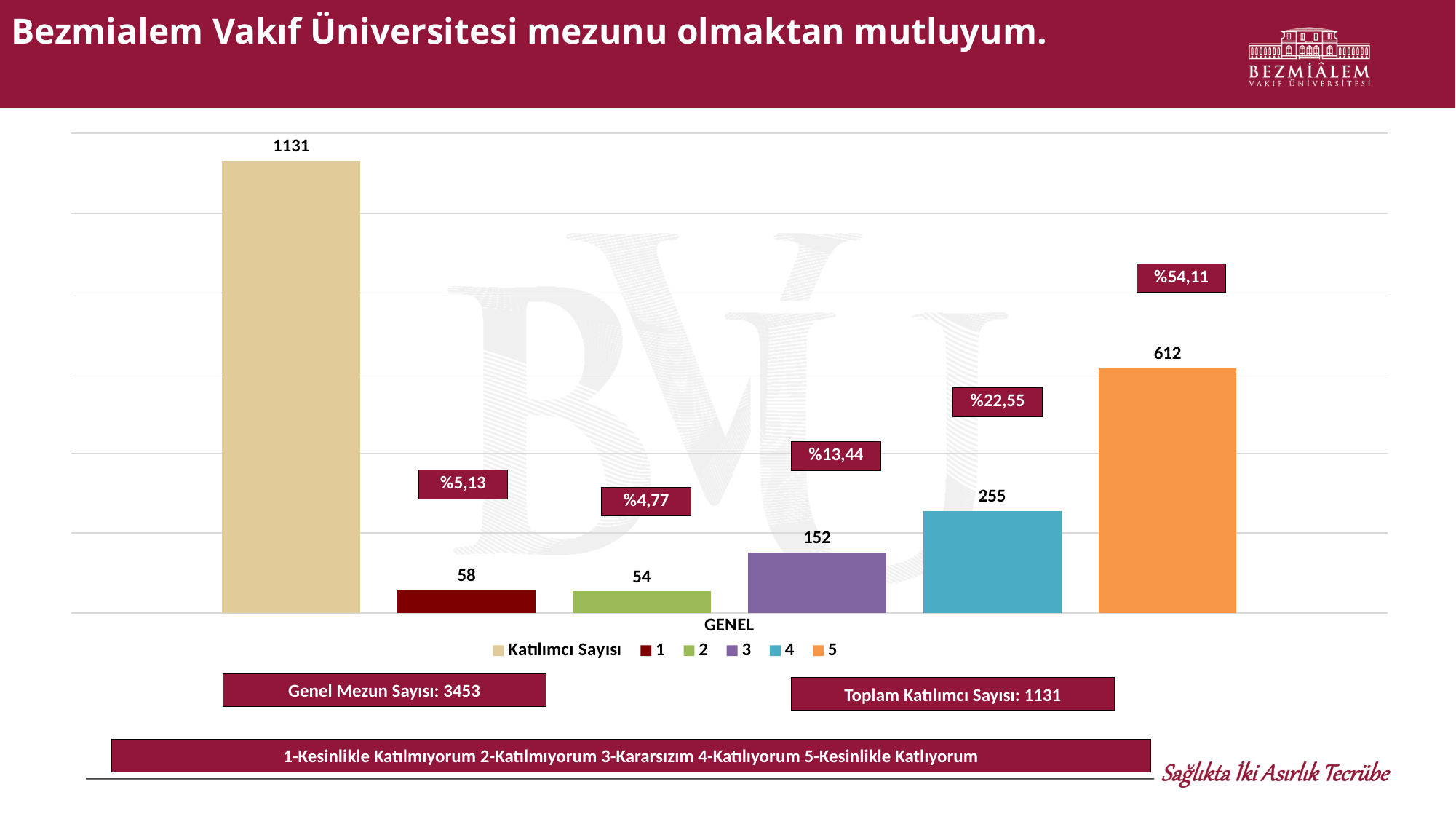
What percentage label is shown above the series 5 bar? %54,11 What is the category label shown on the x axis? GENEL What is the value of series 3 for GENEL? 152 What is the value of the Katılımcı Sayısı bar? 1131 Which of the response series 1 to 5 has the lowest value? 2 How many series does the legend list? 6 What type of chart is shown on the slide? Bar chart Which is larger, the value for series 3 or the value for series 4? 4 What is the value of series 5 for GENEL? 612 What is the value of series 1 for GENEL? 58 What is the difference between the values of series 5 and series 4? 357 Which of the response series 1 to 5 has the highest value? 5